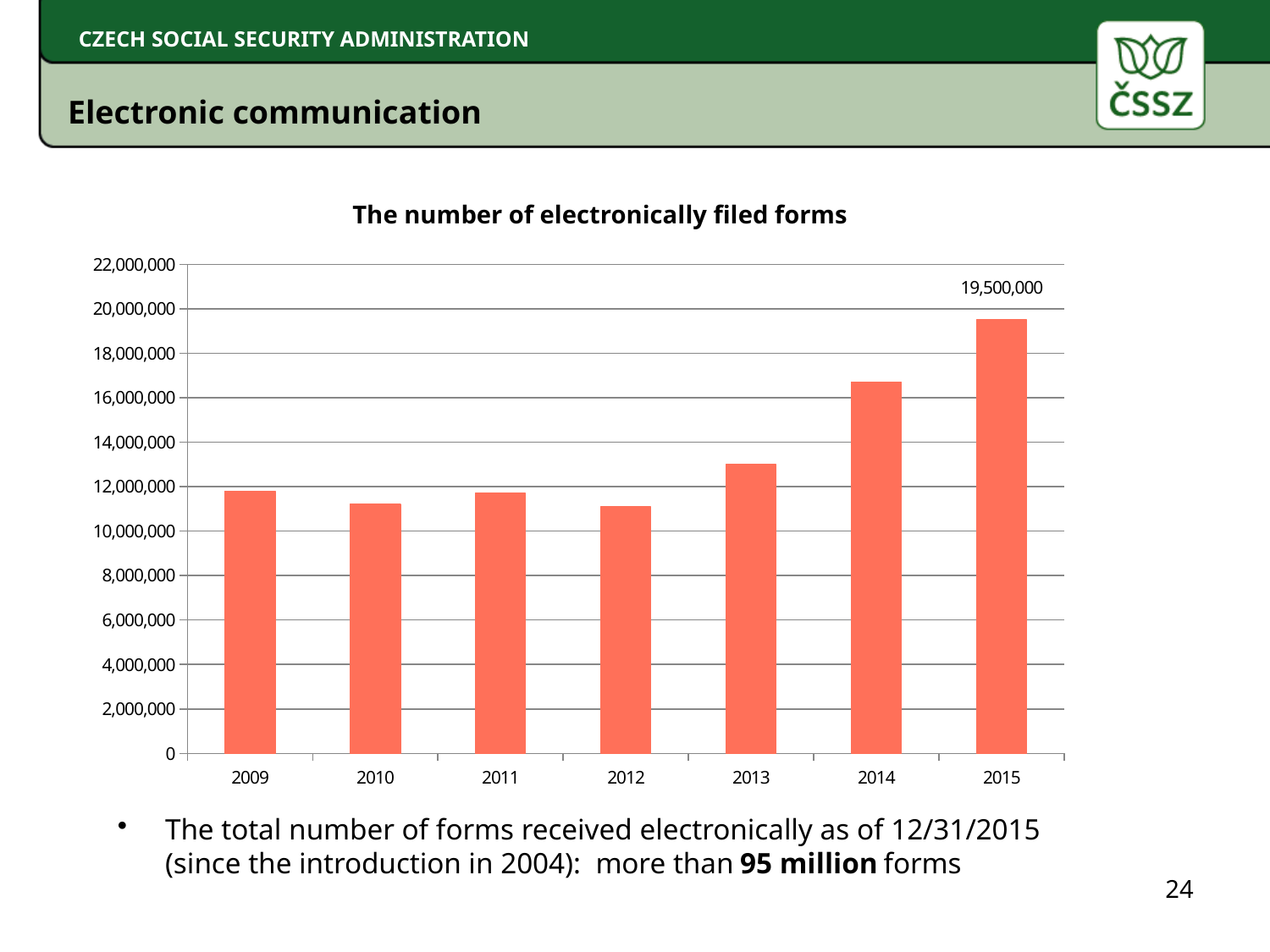
How many years are shown on the x axis of the chart? 7 Is the value for 2013 greater or less than 12,000,000? greater Which year has the highest number of electronically filed forms? 2015 Is the value for 2012 greater or less than 12,000,000? less Is the value for 2009 greater or less than 10,000,000? greater Do the values rise or fall from 2012 to 2015? Rise What is the title of the chart? The number of electronically filed forms Which year has a higher number of electronically filed forms, 2012 or 2013? 2013 What is the number of electronically filed forms in 2015? 19,500,000 What kind of chart is used to show the number of electronically filed forms? Bar chart Which year has a higher number of electronically filed forms, 2013 or 2014? 2014